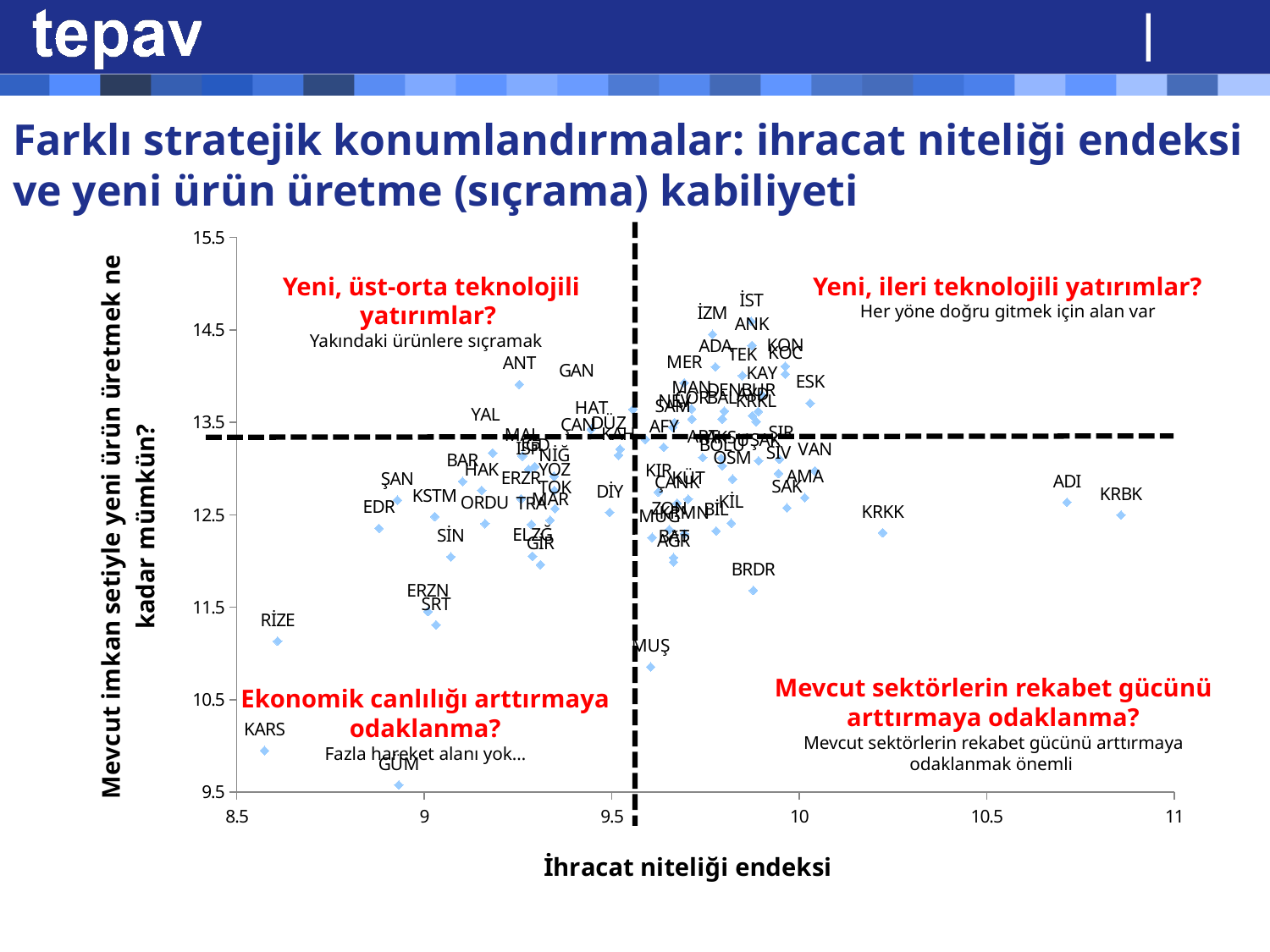
Is the vertical-axis value for KARS greater or less than 10.5? less Is the vertical-axis value for BRDR greater or less than 12.5? less Is the vertical-axis value for ANT greater or less than 13.5? greater What red heading is written in the upper-right quadrant of the chart? Yeni, ileri teknolojili yatırımlar? What kind of chart is shown on the slide? scatter chart Which province label marks the point farthest to the right on the chart? KRBK Which province label marks the lowest point on the vertical axis of the chart? GÜM What is the title of the x axis of the chart? İhracat niteliği endeksi Which point is higher on the vertical axis, İST or RİZE? İST